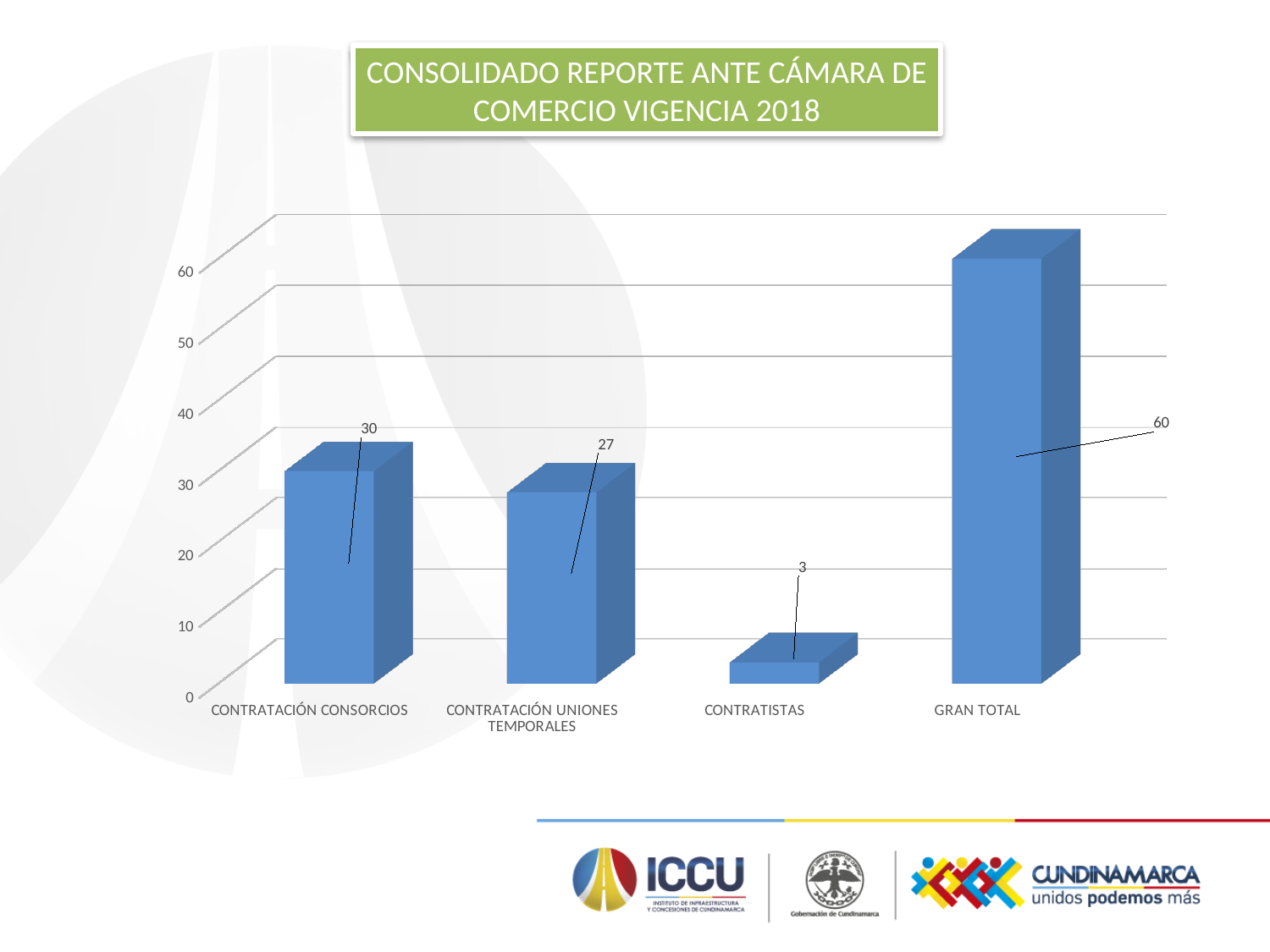
Which category has the lowest value? CONTRATISTAS What is the value for CONTRATACIÓN UNIONES TEMPORALES? 27 Is the value for CONTRATACIÓN UNIONES TEMPORALES greater or less than 20? greater What is the title shown above the chart? CONSOLIDADO REPORTE ANTE CÁMARA DE COMERCIO VIGENCIA 2018 Which category has the highest value? GRAN TOTAL How many categories are shown on the x axis? 4 What is the value for CONTRATISTAS? 3 What is the value for CONTRATACIÓN CONSORCIOS? 30 What is the difference between the values for CONTRATACIÓN CONSORCIOS and CONTRATACIÓN UNIONES TEMPORALES? 3 What kind of chart is shown on the slide? bar chart What is the value for GRAN TOTAL? 60 Which is larger, the value for CONTRATACIÓN CONSORCIOS or the value for CONTRATISTAS? CONTRATACIÓN CONSORCIOS